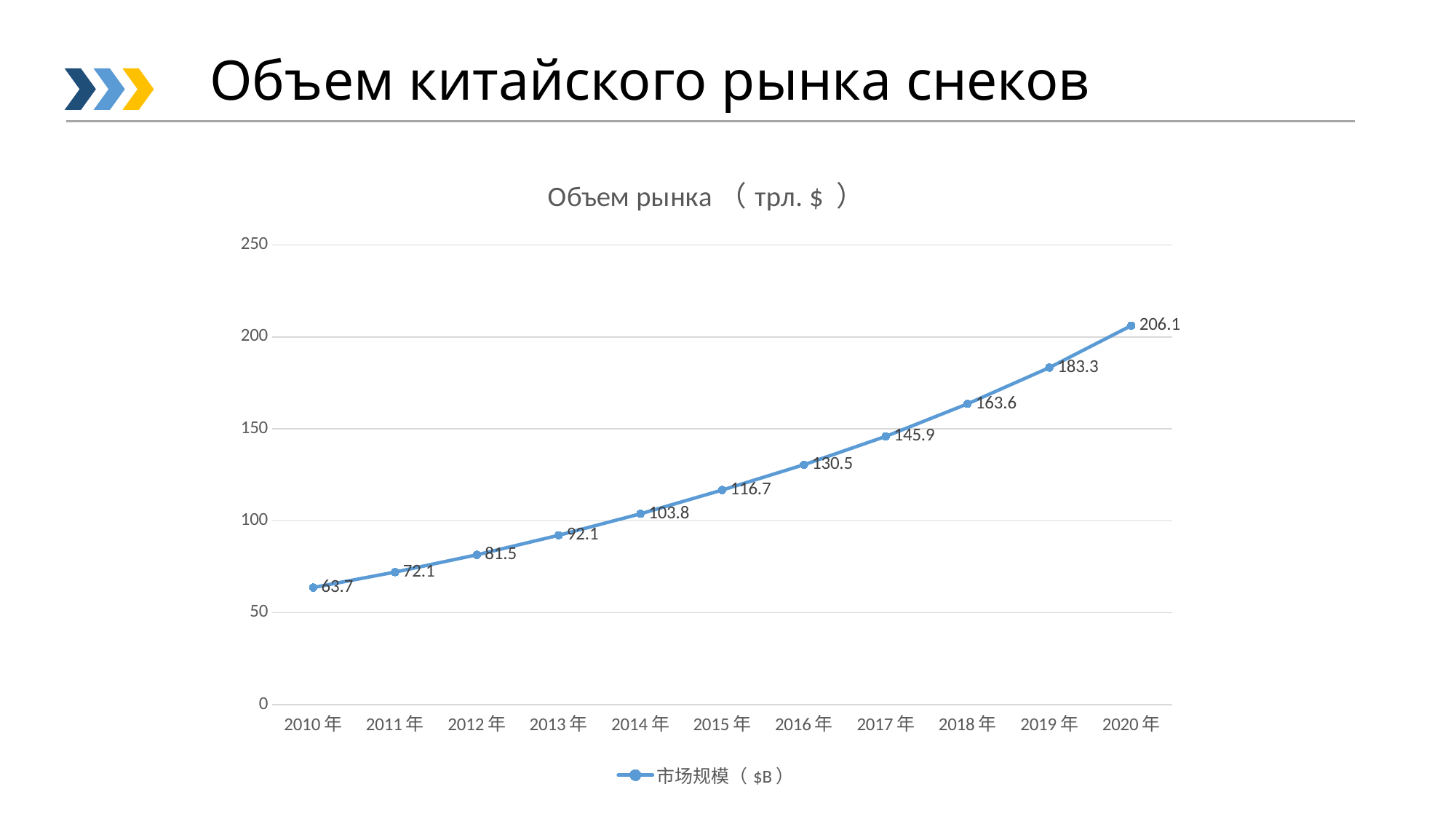
How many years are plotted on the x axis? 11 What is the value for 2020 年? 206.1 How many series does the legend list? 1 What is the difference between the values for 2020 年 and 2019 年? 22.8 Do the values rise or fall from 2010 年 to 2020 年? rise Is the value for 2018 年 greater or less than 150? greater What kind of chart is shown? line chart What is the value for 2015 年? 116.7 Which is larger, the value for 2013 年 or the value for 2016 年? 2016 年 Which year has the lowest value? 2010 年 What is the value for 2010 年? 63.7 Which year has the highest value? 2020 年